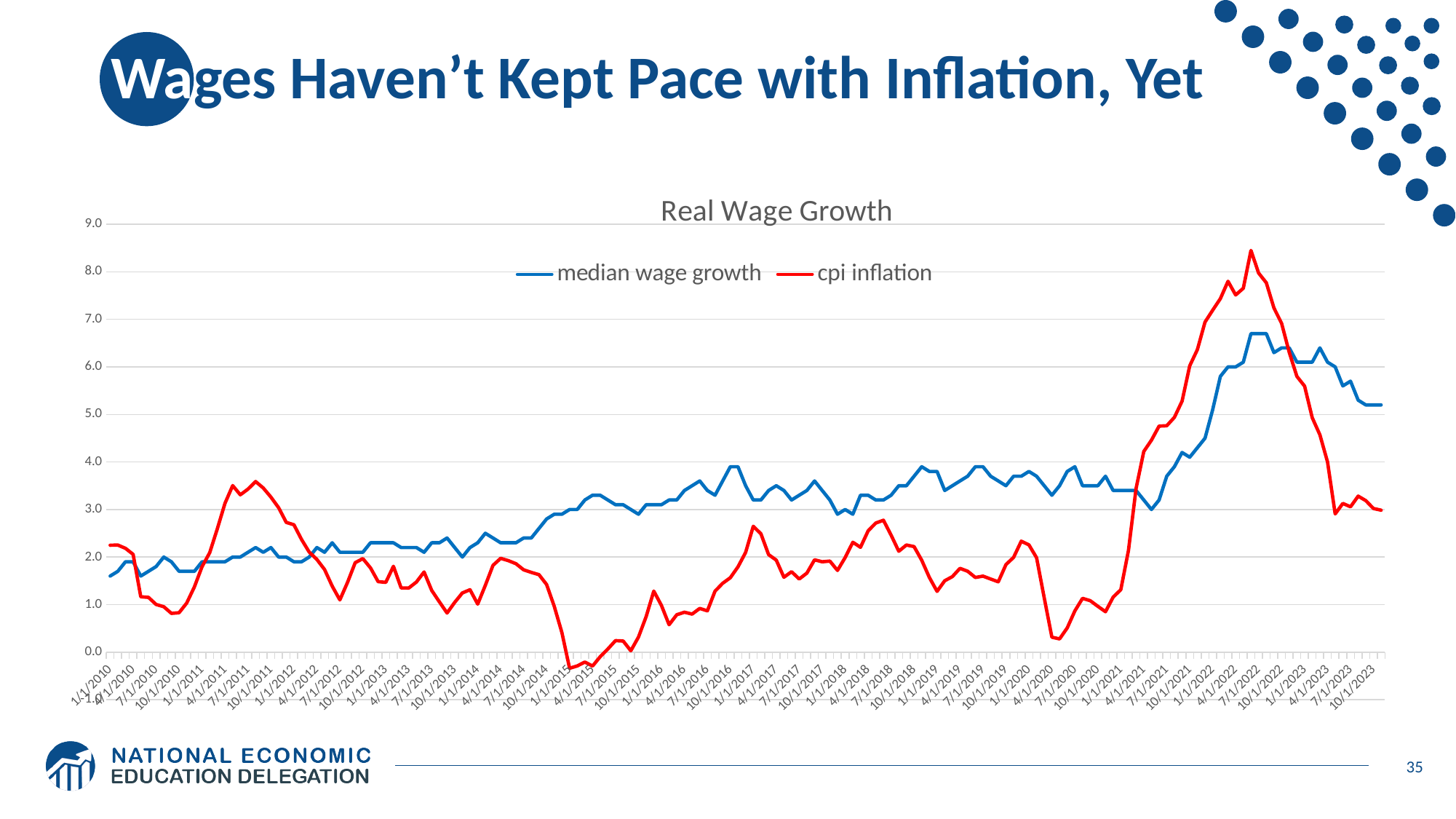
Is the value for cpi inflation at 1/1/2015 greater or less than 1.0? less At 7/1/2022, which series is higher, median wage growth or cpi inflation? cpi inflation Is the value for median wage growth at 1/1/2010 greater or less than 2.0? less What is the title of the chart? Real Wage Growth Is the highest value reached by median wage growth greater or less than 6.0? greater Which series reaches the highest value anywhere on the chart? cpi inflation At 10/1/2023, which series is higher, median wage growth or cpi inflation? median wage growth How many series does the legend of the chart list? 2 What kind of chart is shown on the slide? line chart Does cpi inflation rise or fall between 7/1/2022 and 10/1/2023? fall What colour is the cpi inflation line in the chart? red